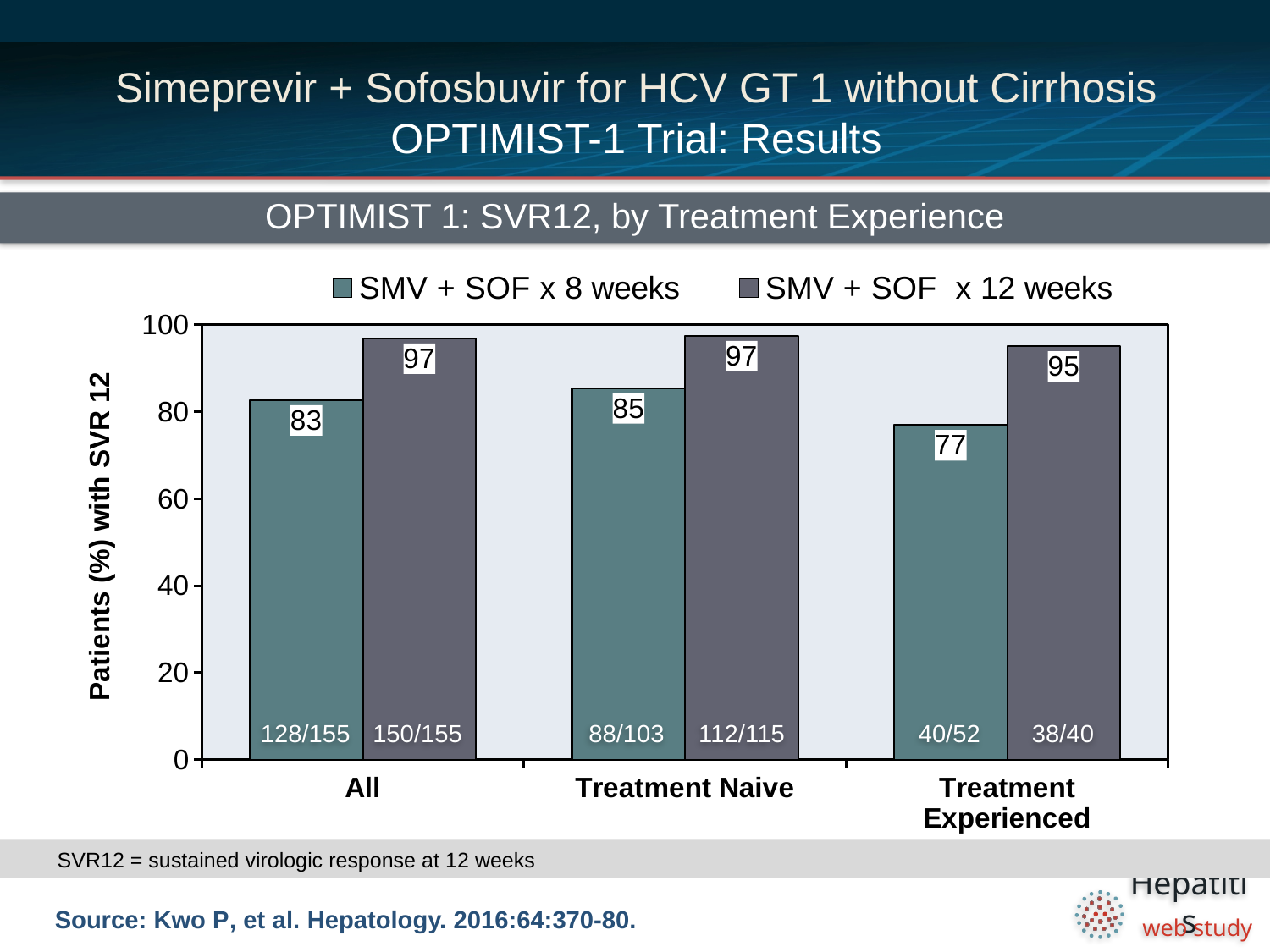
What is the SVR12 rate for SMV + SOF x 12 weeks in the Treatment Experienced group? 95 What kind of chart is shown on the slide? Bar chart What is the label of the y axis? Patients (%) with SVR 12 How many treatment experience categories are shown on the x axis? 3 What fraction of patients is shown for SMV + SOF x 12 weeks in the Treatment Naive group? 112/115 Which is larger in the Treatment Naive group: the SVR12 rate for 8 weeks or for 12 weeks? 12 weeks How many series does the legend list? 2 What is the SVR12 rate for SMV + SOF x 8 weeks in the Treatment Naive group? 85 Which treatment experience group has the lowest SVR12 rate for SMV + SOF x 8 weeks? Treatment Experienced What is the difference between the 12-week and 8-week SVR12 rates in the Treatment Experienced group? 18 What is the SVR12 rate for SMV + SOF x 8 weeks in the All group? 83 What is the difference between the 12-week and 8-week SVR12 rates in the All group? 14